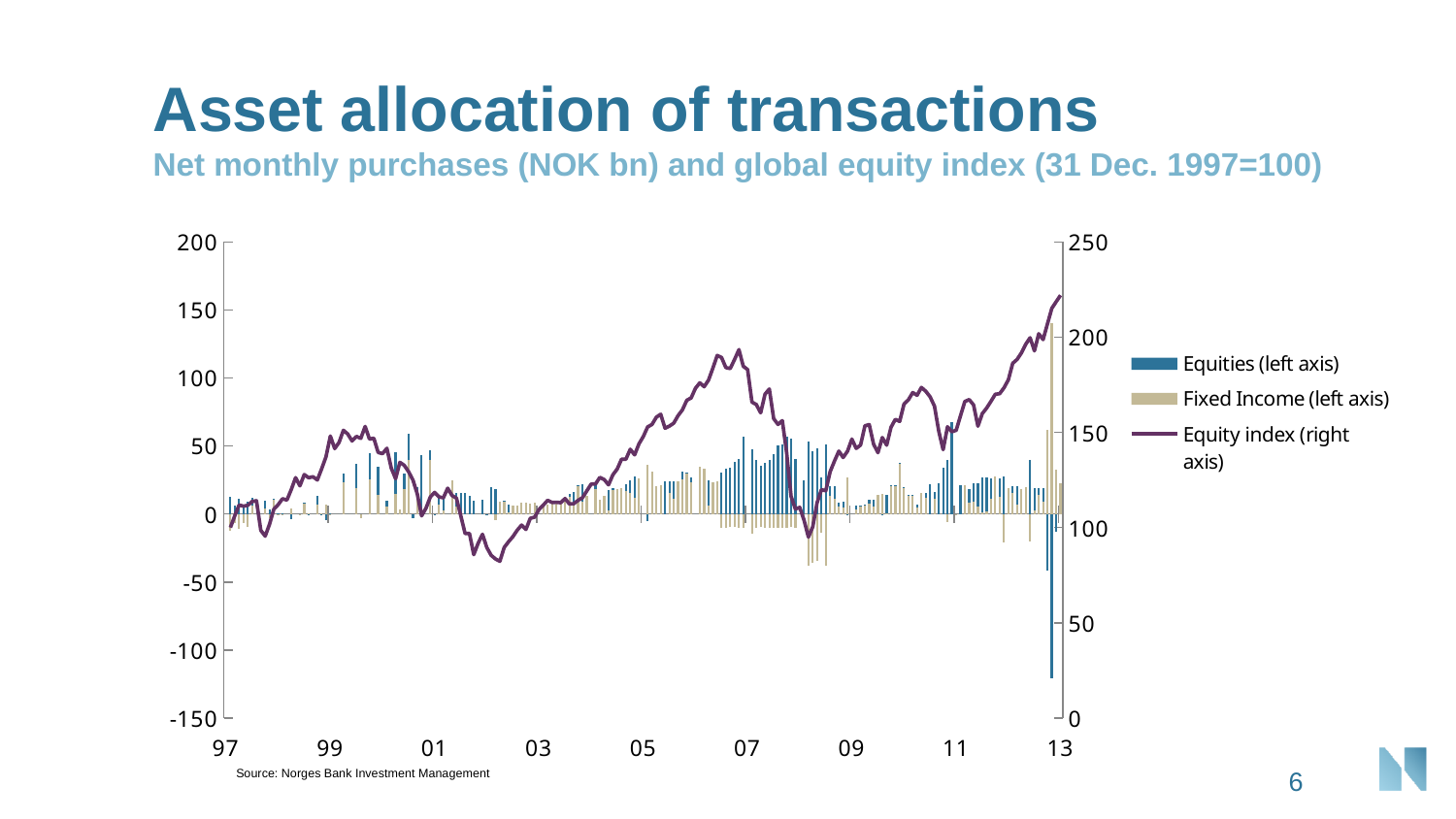
Which series is plotted on the right axis? Equity index Is the value of the Equity index at the end of the series (2013) greater or less than 200? greater How many series does the legend list? 3 How many year labels are shown on the x axis? 9 What is the title of the chart on the slide? Asset allocation of transactions Does the Equity index rise or fall overall between 2009 and 2013? rise Is the value of the Equity index at its low point in 2003 greater or less than 100? less Is the tallest Fixed Income bar, near 2013, greater or less than 150? less What kind of chart is this? Combined bar and line chart